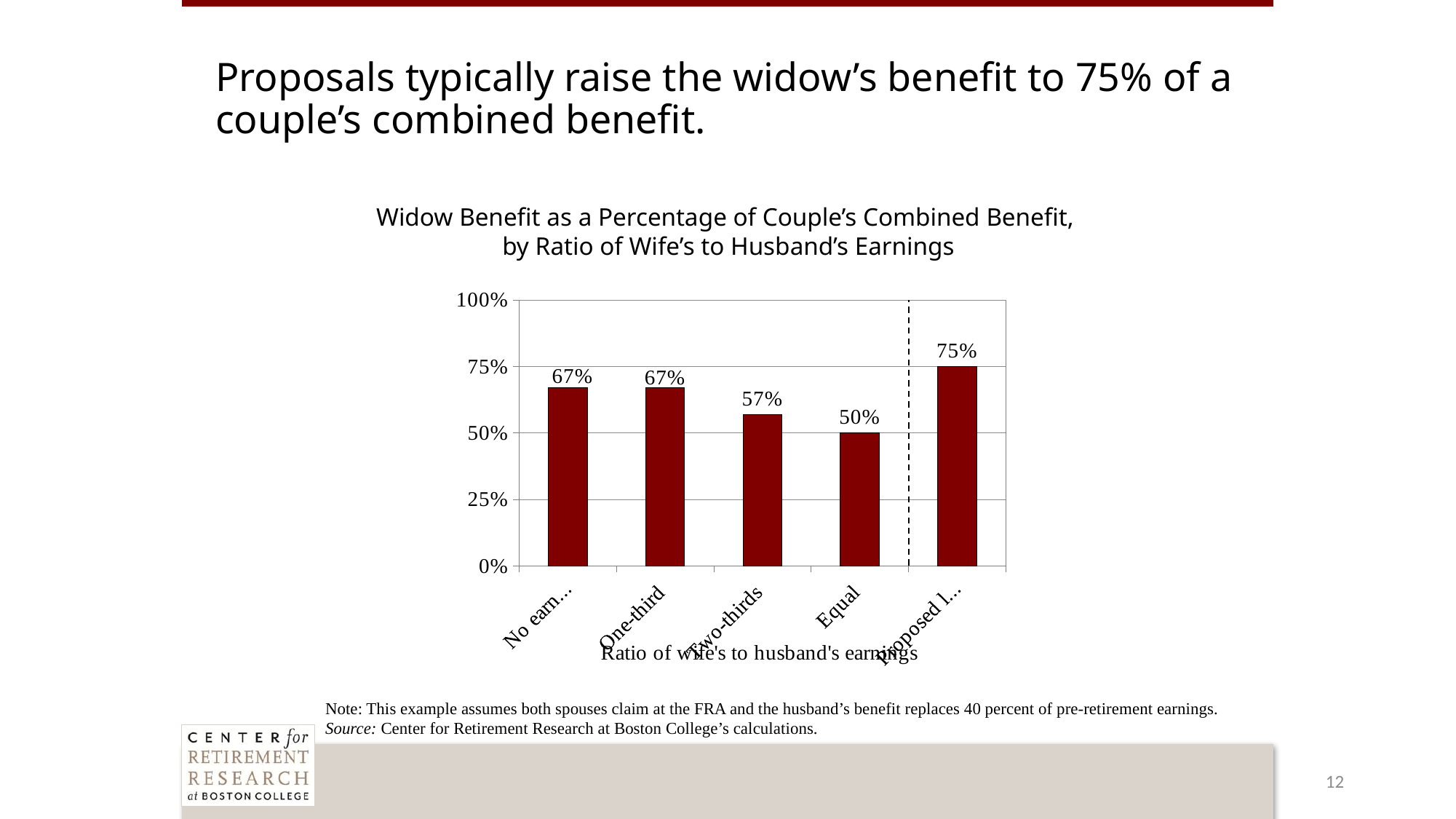
Which is larger, the value for 'Two-thirds' or the value for 'Equal'? Two-thirds What is the difference between the 'One-third' value and the 'Equal' value? 17% What type of chart is shown on the slide? bar chart What is the value of the rightmost bar, to the right of the dashed line? 75% What is the difference between the rightmost bar (75%) and the 'Two-thirds' bar? 18% What is the widow benefit as a percentage of the couple's combined benefit when the wife's earnings are one-third of the husband's? 67% Is the value for 'Two-thirds' greater or less than 50%? greater What is the value for the 'Equal' category? 50% What is the value for the 'Two-thirds' category? 57% How many bars are plotted in the chart? 5 Which category has the lowest value in the chart? Equal What is the x-axis title of the chart? Ratio of wife's to husband's earnings